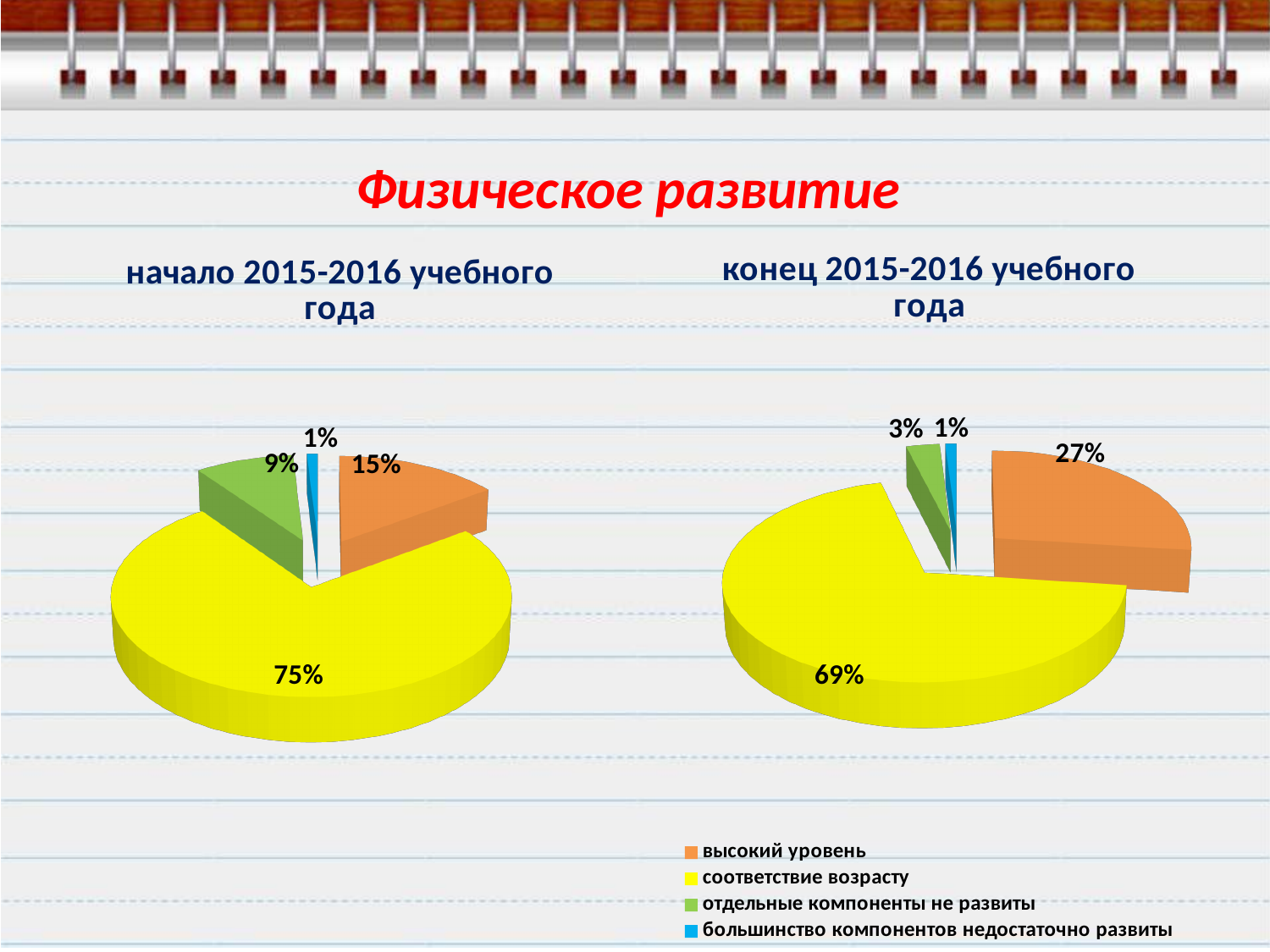
Which is larger: the "соответствие возрасту" share in the left chart (начало 2015-2016 учебного года) or in the right chart (конец 2015-2016 учебного года)? the left chart (начало 2015-2016 учебного года) In the chart titled "начало 2015-2016 учебного года", which category has the largest slice? соответствие возрасту What type of chart is used on this slide? pie chart What is the difference between the "высокий уровень" share in the right chart (конец 2015-2016 учебного года) and in the left chart (начало 2015-2016 учебного года)? 12% In the chart titled "начало 2015-2016 учебного года", what is the value for "отдельные компоненты не развиты"? 9% What colour represents "высокий уровень" in the charts? orange How many categories does the legend list? 4 In the chart titled "конец 2015-2016 учебного года", what is the value for "большинство компонентов недостаточно развиты"? 1% In the chart titled "конец 2015-2016 учебного года", what share does "высокий уровень" have? 27% In the chart titled "конец 2015-2016 учебного года", what is the value for "отдельные компоненты не развиты"? 3% In the chart titled "начало 2015-2016 учебного года", what share does "соответствие возрасту" have? 75% In the chart titled "конец 2015-2016 учебного года", which category has the smallest slice? большинство компонентов недостаточно развиты